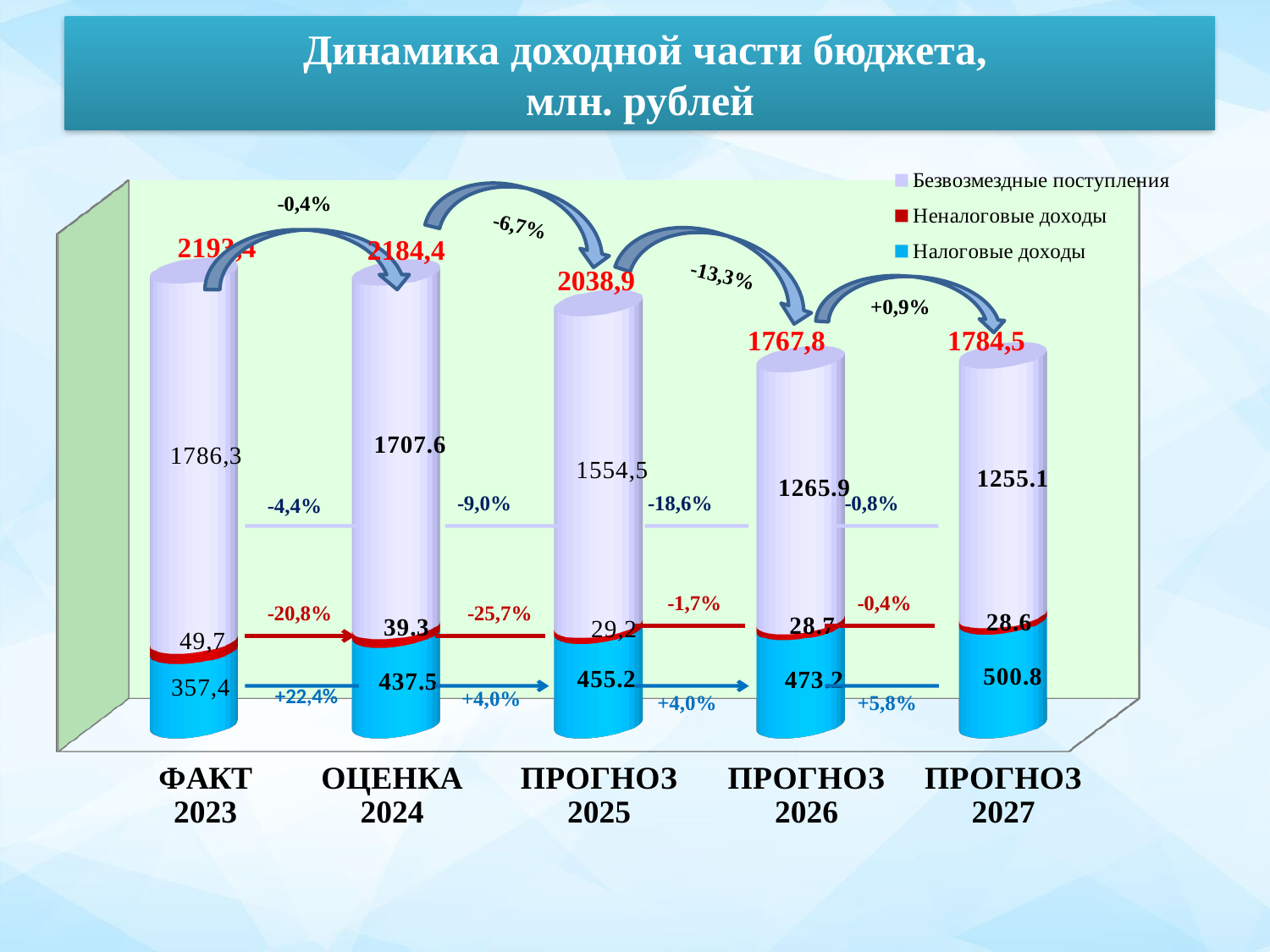
Which category has the lowest value of Безвозмездные поступления? ПРОГНОЗ 2027 What kind of chart is shown on the slide? bar chart Do the values of Безвозмездные поступления rise or fall from ФАКТ 2023 to ПРОГНОЗ 2027? fall What is the total of the stacked bar for ПРОГНОЗ 2026? 1767,8 What is the difference between Налоговые доходы for ПРОГНОЗ 2027 and ПРОГНОЗ 2026? 27.6 Which is larger, Налоговые доходы for ПРОГНОЗ 2025 or for ПРОГНОЗ 2026? ПРОГНОЗ 2026 Which category has the highest value of Налоговые доходы? ПРОГНОЗ 2027 How many series does the legend list? 3 What is the value of Неналоговые доходы for ОЦЕНКА 2024? 39.3 What is the value of Безвозмездные поступления for ФАКТ 2023? 1786,3 What is the value of Налоговые доходы for ПРОГНОЗ 2027? 500.8 How many categories are shown on the x axis? 5